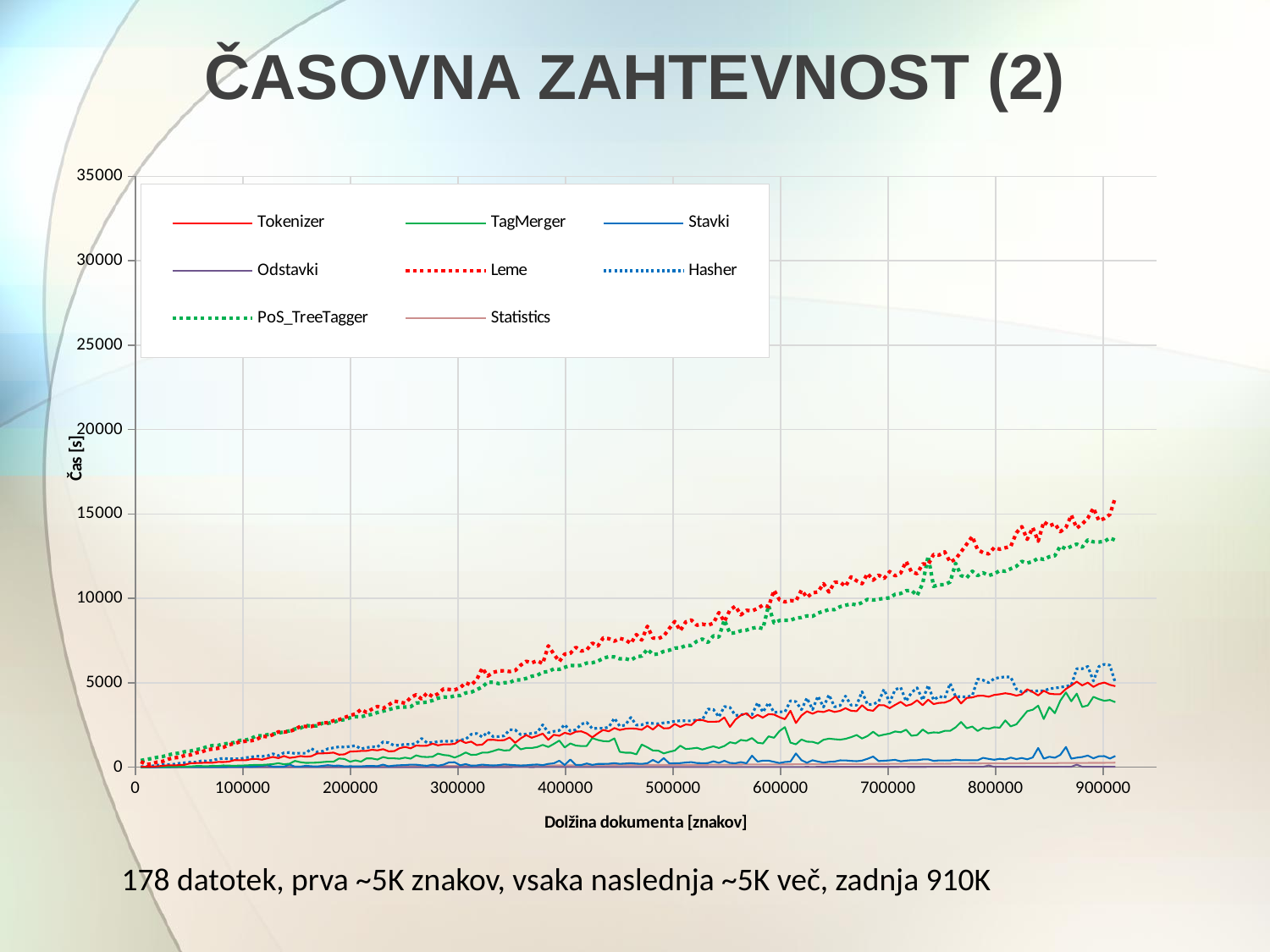
What is the title of the y axis of the chart? Čas [s] Which series reaches the highest value at the right end of the chart (around 900000 characters)? Leme At a document length of 800000, which series has the larger value, Leme or Tokenizer? Leme What kind of chart is shown on the slide? line chart Is the value for PoS_TreeTagger at a document length of 900000 greater or less than 15000? less How many series does the legend list? 8 What is the title of the x axis of the chart? Dolžina dokumenta [znakov] At a document length of 900000, which series has the larger value, Leme or PoS_TreeTagger? Leme Do the values for the Leme series rise or fall as document length increases along the x axis? rise Is the value for Stavki at a document length of 900000 greater or less than 5000? less Is the value for TagMerger at a document length of 900000 greater or less than 5000? less